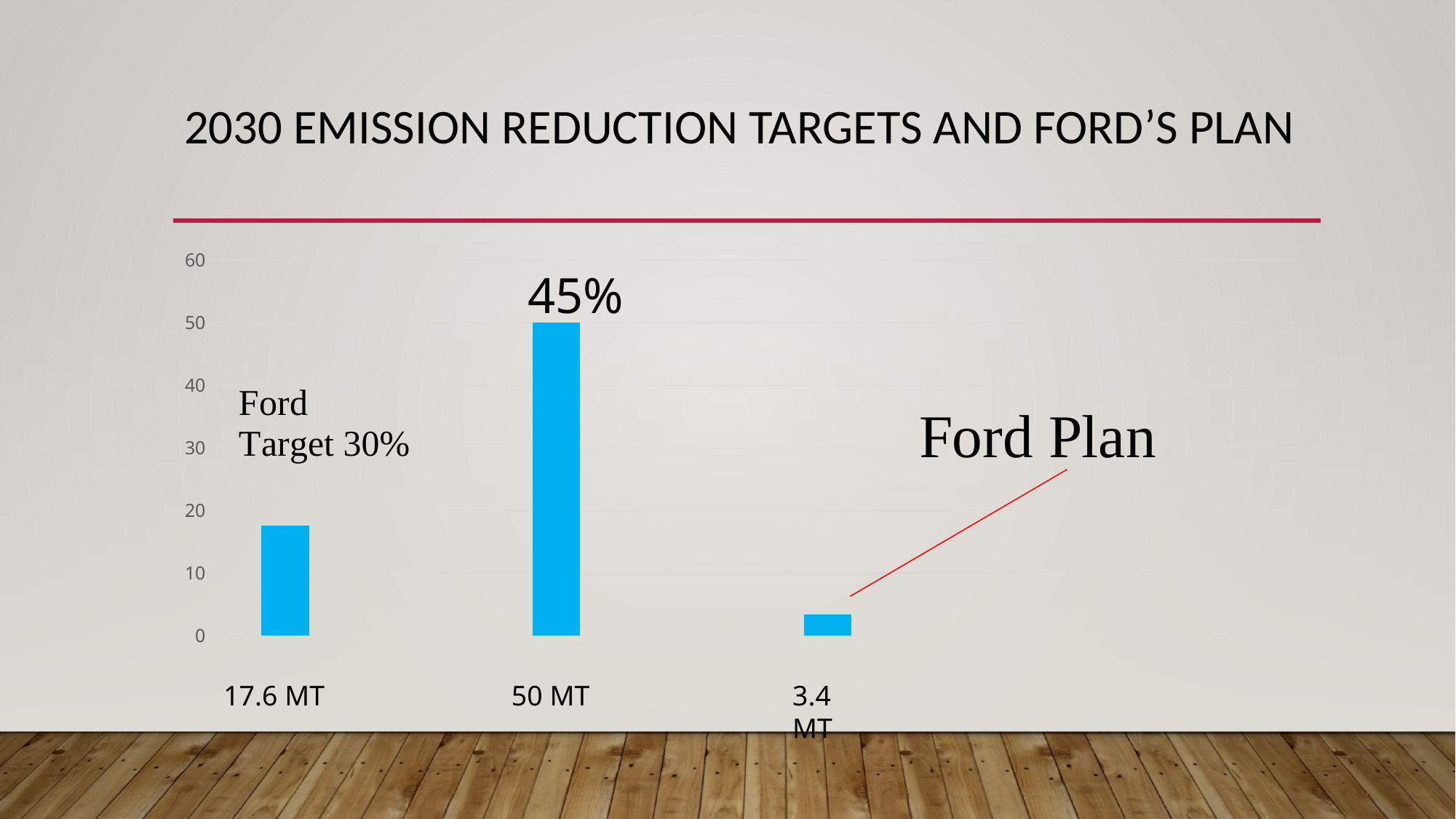
What kind of chart is shown on the slide? bar chart What percentage label is written above the 50 MT bar? 45% Is the value for the 17.6 MT bar greater or less than 10? greater What is the title of the slide containing the chart? 2030 Emission Reduction Targets and Ford's Plan Is the value for the 3.4 MT bar greater or less than 10? less Does the value rise or fall from the 50 MT bar to the 3.4 MT bar? fall Is the value for the 17.6 MT bar greater or less than 20? less How many bars are plotted in the chart? 3 Which category has the shortest bar? 3.4 MT What value on the vertical axis does the 50 MT bar reach? 50 Which category has the tallest bar? 50 MT Which bar is taller, 17.6 MT or 3.4 MT? 17.6 MT